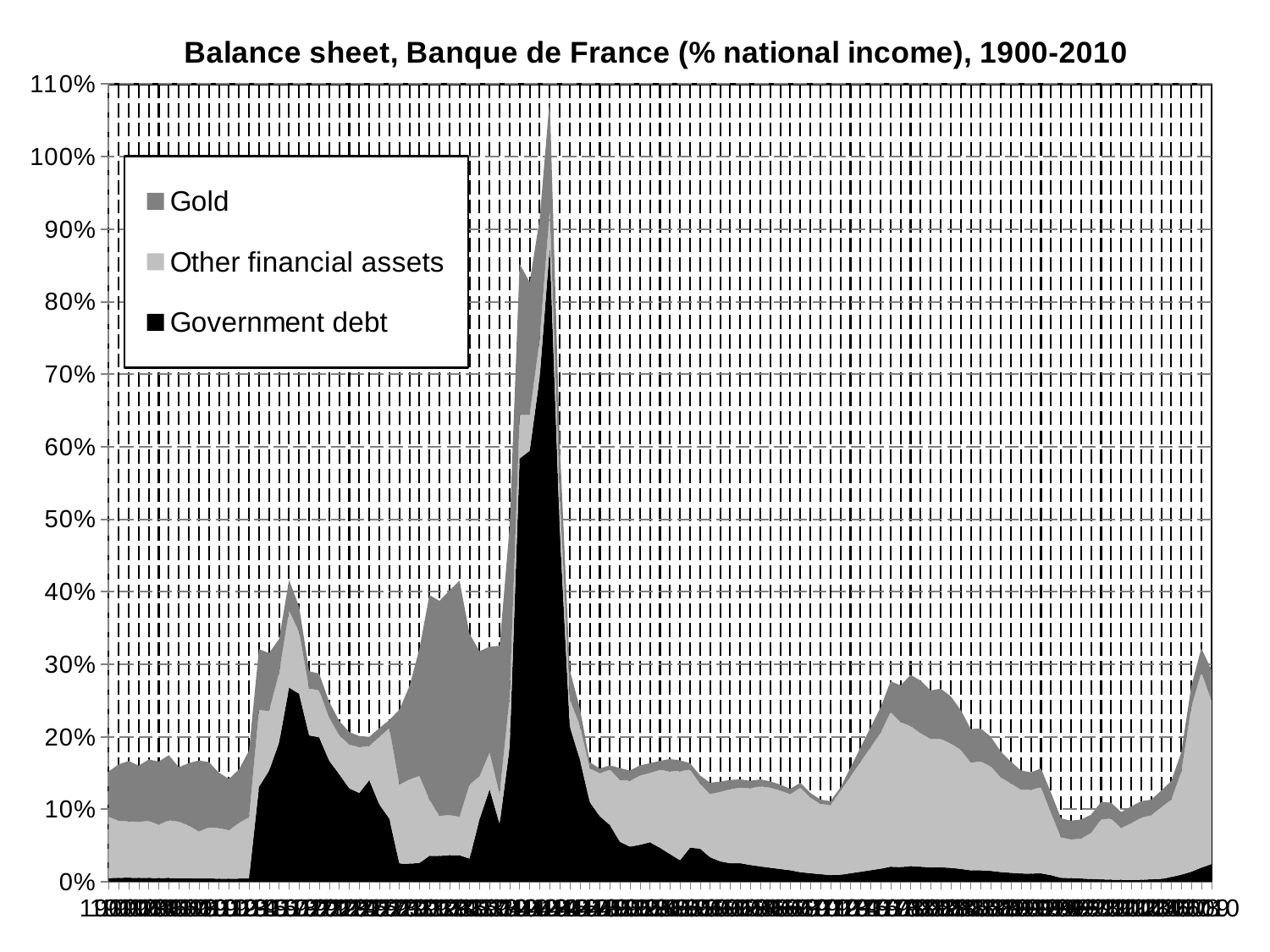
Which series accounts for most of the total at the chart's highest peak? Government debt Is the total value at the very end of the chart greater or less than 20%? greater What is the title of the chart? Balance sheet, Banque de France (% national income), 1900-2010 What kind of chart is shown on the slide? Stacked area chart Which series makes up most of the total in the final years of the chart? Other financial assets Is the total value at the very start of the chart greater or less than 20%? less Is the peak total value of the chart greater or less than 100%? greater Which series is shown in black? Government debt What is the highest value shown on the y axis? 110% How many series does the legend list? 3